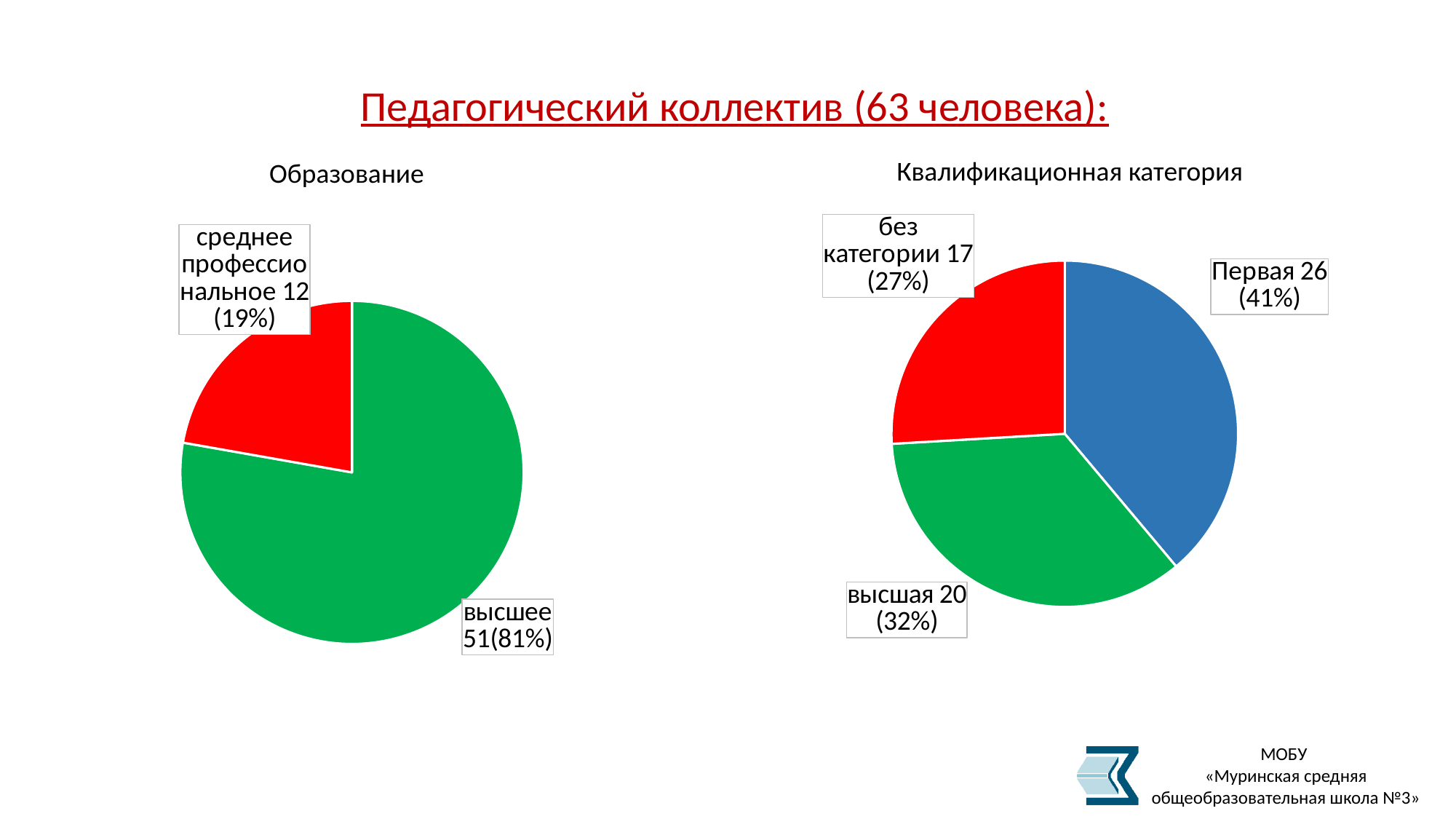
In the "Квалификационная категория" chart, how many people have the first category (Первая)? 26 In the "Образование" chart, which category is the largest? высшее What type of chart is the "Образование" chart? pie chart In the "Квалификационная категория" chart, which is larger: "высшая" or "Первая"? Первая In the "Квалификационная категория" chart, what is the difference between "Первая" and "высшая"? 6 In the "Квалификационная категория" chart, how many categories are shown? 3 In the "Квалификационная категория" chart, which category is the smallest? без категории In the "Образование" chart, what share of the pie is "среднее профессиональное"? 19% In the "Квалификационная категория" chart, what colour is the "Первая" slice? blue In the "Образование" chart, how many people have higher education (высшее)? 51 In the "Образование" chart, what is the difference between the number with higher education and the number with secondary vocational education? 39 In the "Квалификационная категория" chart, what share of the pie is "без категории"? 27%